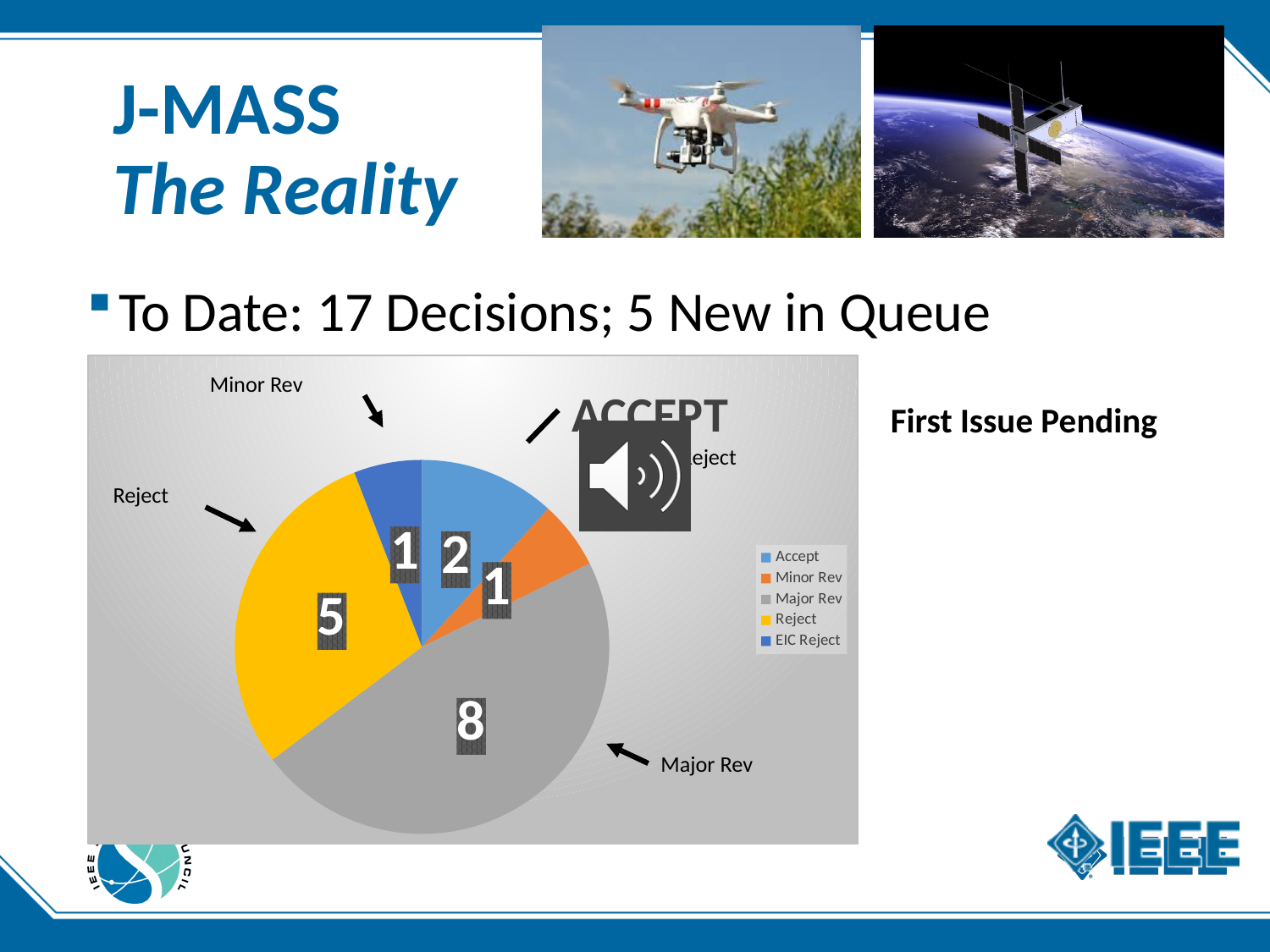
What is the value for Major Rev in the pie chart? 8 Which legend entry is shown in yellow in the pie chart? Reject What kind of chart is shown on the slide? pie chart How many categories does the legend of the pie chart list? 5 What is the difference between the Major Rev and Reject values in the pie chart? 3 What is the value for Minor Rev in the pie chart? 1 Which category has the largest slice in the pie chart? Major Rev What is the value for Accept in the pie chart? 2 Which is larger in the pie chart, Reject or Accept? Reject What is the total of all slices in the pie chart? 17 What is the value for Reject in the pie chart? 5 Which legend entry is shown in gray in the pie chart? Major Rev